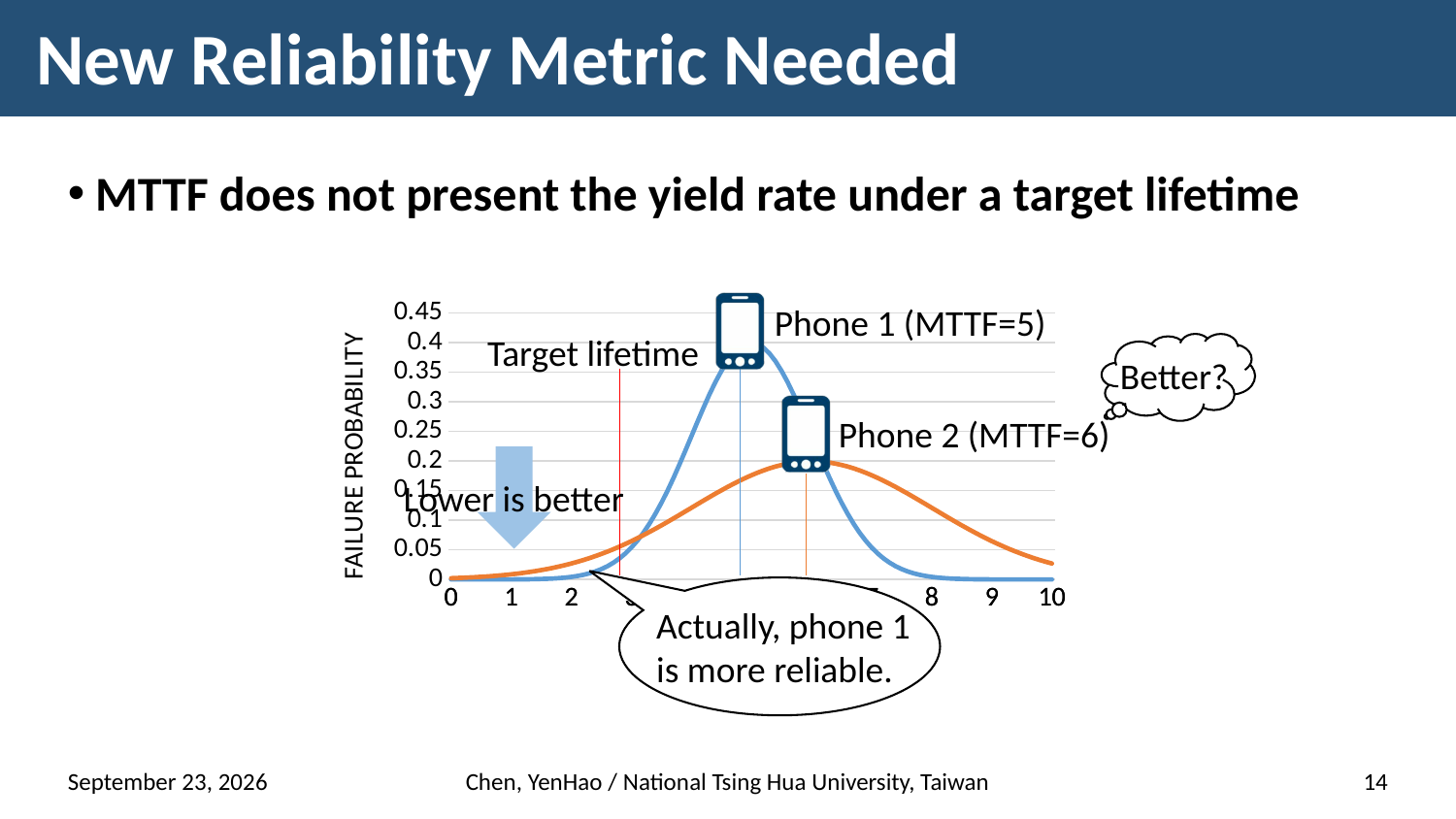
Is the peak failure probability of Phone 1 greater or less than 0.35? greater How many curves (phones) are plotted on the chart? 2 Which phone's curve reaches the higher peak failure probability? Phone 1 What kind of chart is shown on the slide? line chart What is the largest value shown on the horizontal axis? 10 What is the MTTF value stated for Phone 1 on the chart? 5 What is the highest value shown on the vertical axis? 0.45 Which phone's curve is more spread out (wider) along the x axis? Phone 2 What is the label of the vertical axis of the chart? FAILURE PROBABILITY Is the peak failure probability of Phone 2 greater or less than 0.25? less What is the MTTF value stated for Phone 2 on the chart? 6